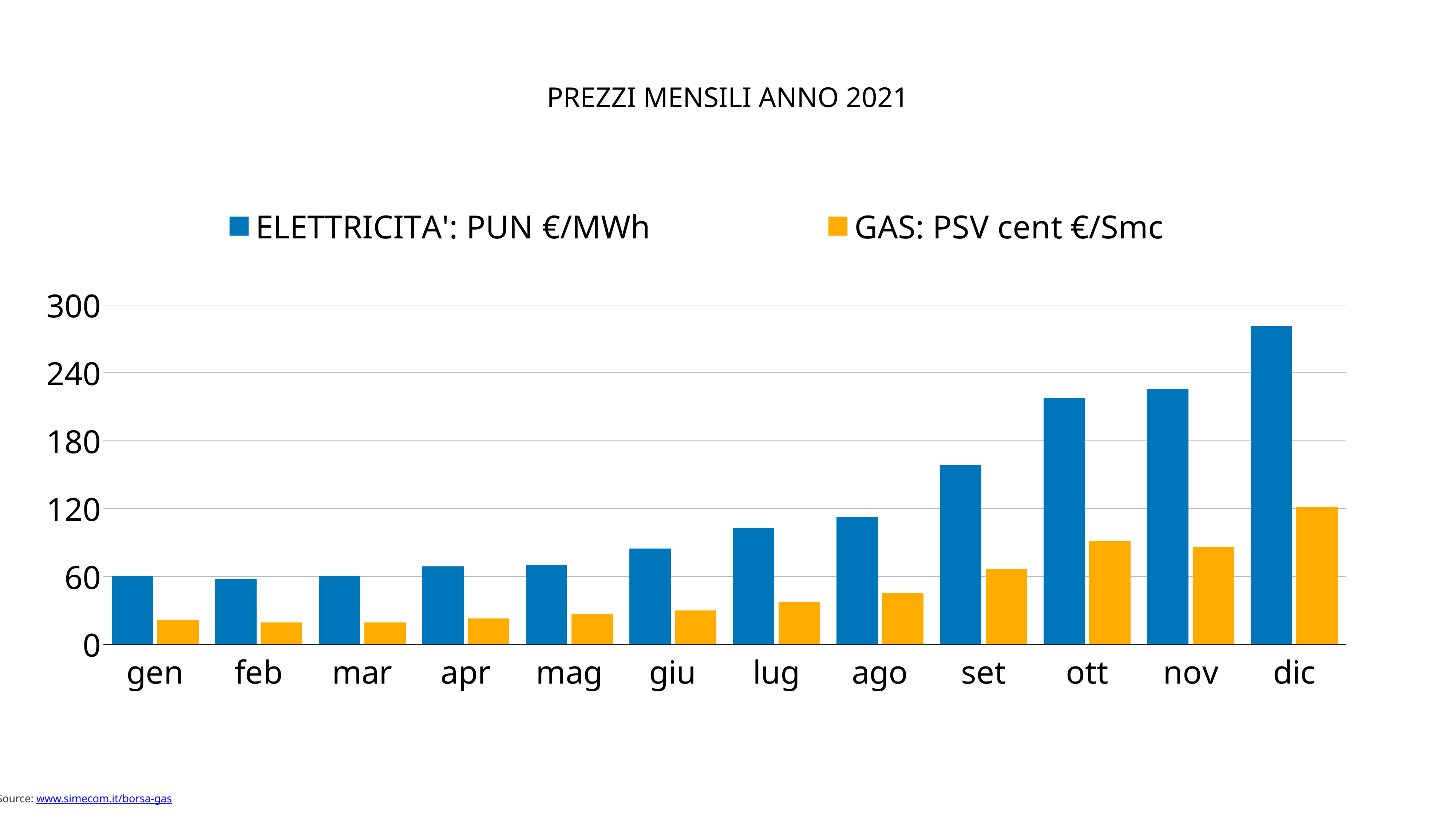
Which is larger, the ELETTRICITA': PUN €/MWh value for nov or for dic? dic How many months are shown on the x axis? 12 What kind of chart is shown on the slide? bar chart Is the GAS: PSV cent €/Smc value for ott greater or less than 60? greater Do the ELETTRICITA': PUN €/MWh values generally rise or fall from gen to dic? rise How many series does the legend list? 2 What is the title of the chart? PREZZI MENSILI ANNO 2021 Which month has the highest value for ELETTRICITA': PUN €/MWh? dic Which month has the highest value for GAS: PSV cent €/Smc? dic Is the GAS: PSV cent €/Smc value for gen greater or less than 60? less Is the ELETTRICITA': PUN €/MWh value for dic greater or less than 240? greater